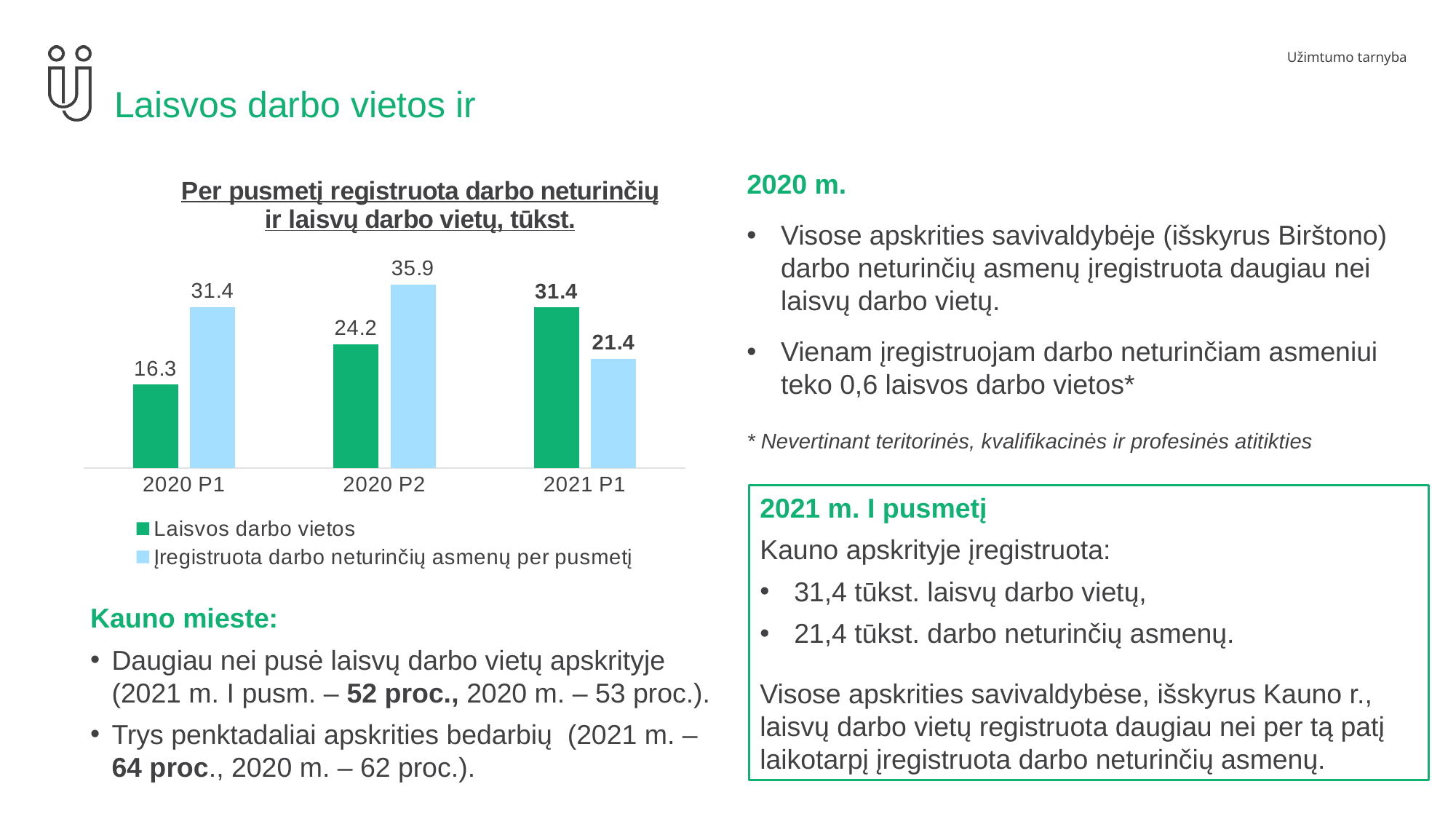
In which period is the value for Įregistruota darbo neturinčių asmenų per pusmetį lowest? 2021 P1 What kind of chart is shown on the slide? Bar chart What is the value for Įregistruota darbo neturinčių asmenų per pusmetį in 2020 P2? 35.9 Does the value for Laisvos darbo vietos rise or fall from 2020 P1 to 2021 P1? Rise In which period is the value for Laisvos darbo vietos highest? 2021 P1 What is the value for Įregistruota darbo neturinčių asmenų per pusmetį in 2021 P1? 21.4 In 2021 P1, which is larger: Laisvos darbo vietos or Įregistruota darbo neturinčių asmenų per pusmetį? Laisvos darbo vietos What is the difference between the Laisvos darbo vietos values in 2021 P1 and 2020 P2? 7.2 What is the value for Laisvos darbo vietos in 2020 P1? 16.3 How many series does the chart legend list? 2 How many periods are shown on the x axis of the chart? 3 What is the difference between Įregistruota darbo neturinčių asmenų per pusmetį and Laisvos darbo vietos in 2020 P1? 15.1